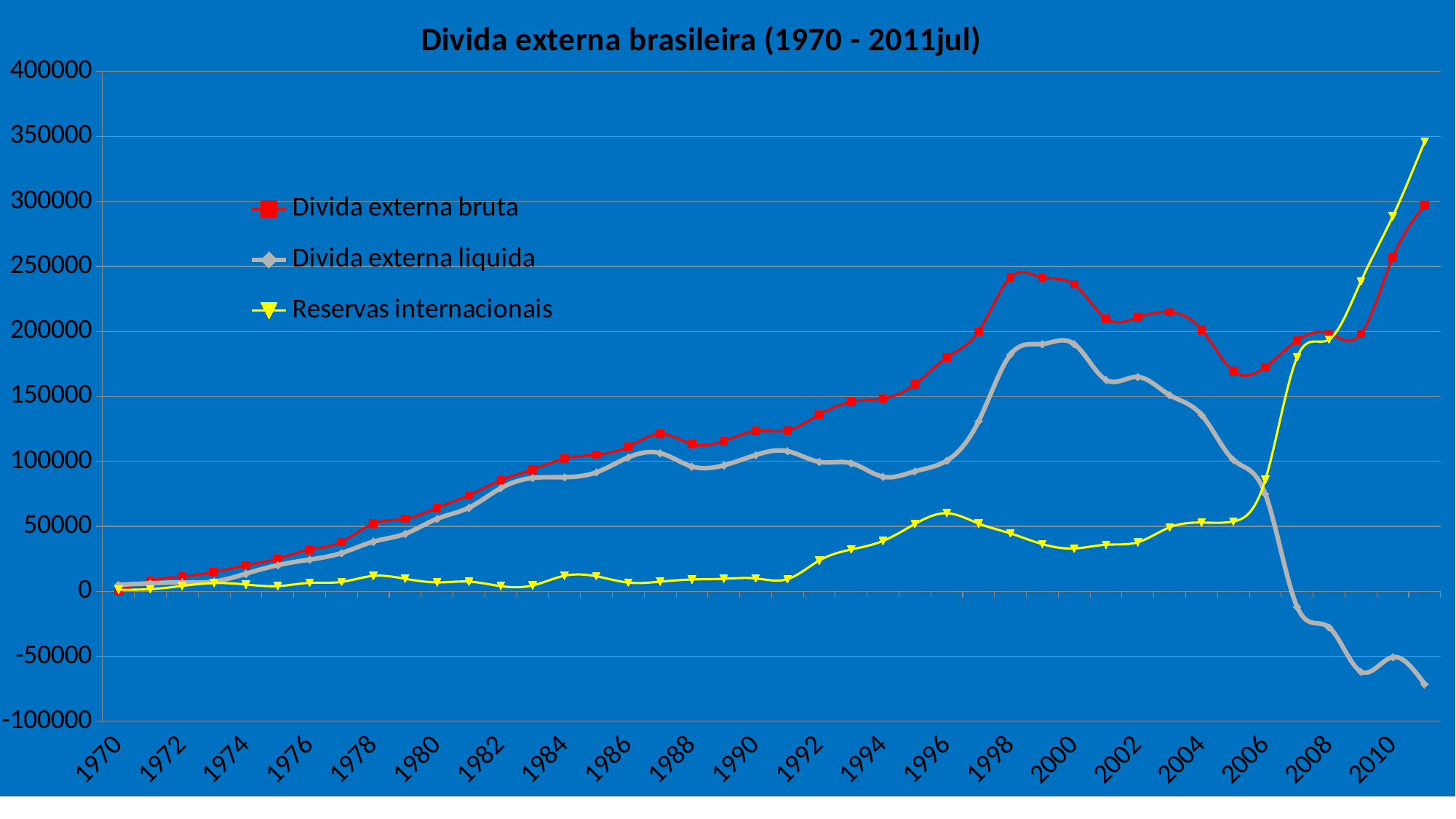
Which colour is used for the Reservas internacionais series? yellow In 1998, which is larger: Divida externa bruta or Divida externa liquida? Divida externa bruta Which series has the highest value at the final point of the chart (2011jul)? Reservas internacionais How many series does the legend list? 3 Is the value of Divida externa bruta in 1998 greater or less than 200000? greater Is the value of Divida externa liquida in 2010 greater or less than 0? less Does the Reservas internacionais series rise or fall between 2004 and 2010? rise Is the value of Reservas internacionais in 2010 greater or less than 250000? greater Does the Divida externa liquida series rise or fall between 2006 and 2010? fall What is the title of the chart? Divida externa brasileira (1970 - 2011jul) What kind of chart is shown on the slide? line chart